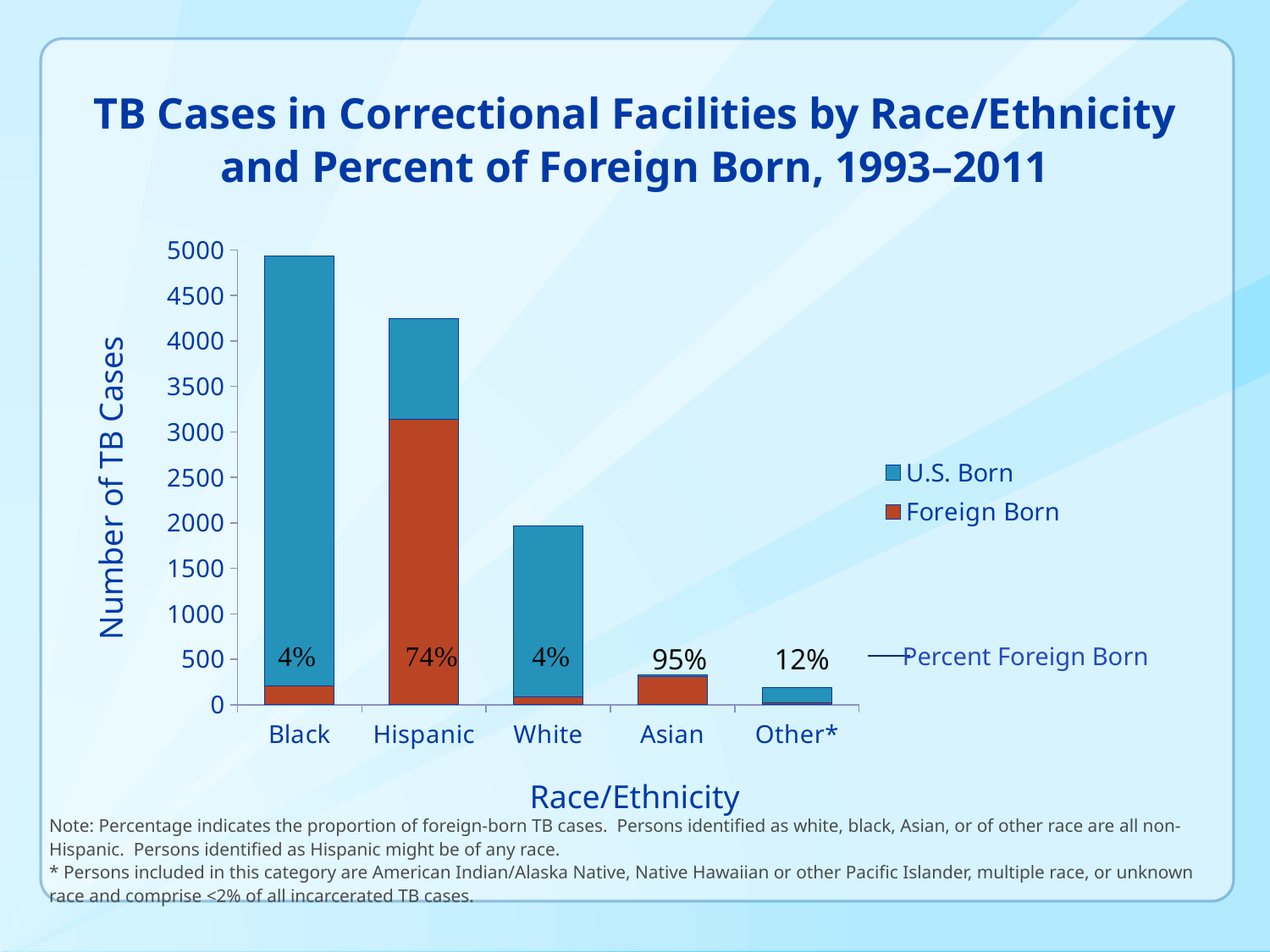
Which race/ethnicity category has the tallest total bar of TB cases? Black What is the percent foreign born shown for Other*? 12% Which race/ethnicity category has the highest percent foreign born? Asian How many race/ethnicity categories are shown on the x axis? 5 What is the percent foreign born shown for Black? 4% What is the difference in percent foreign born between Asian and Hispanic? 21% Is the total number of TB cases for Hispanic greater or less than 4500? less Which race/ethnicity category has the shortest total bar of TB cases? Other* What is the percent foreign born shown for Hispanic? 74% What is the percent foreign born shown for Asian? 95% What kind of chart is shown on the slide? Stacked bar chart Is the total number of TB cases for White greater or less than 1500? greater